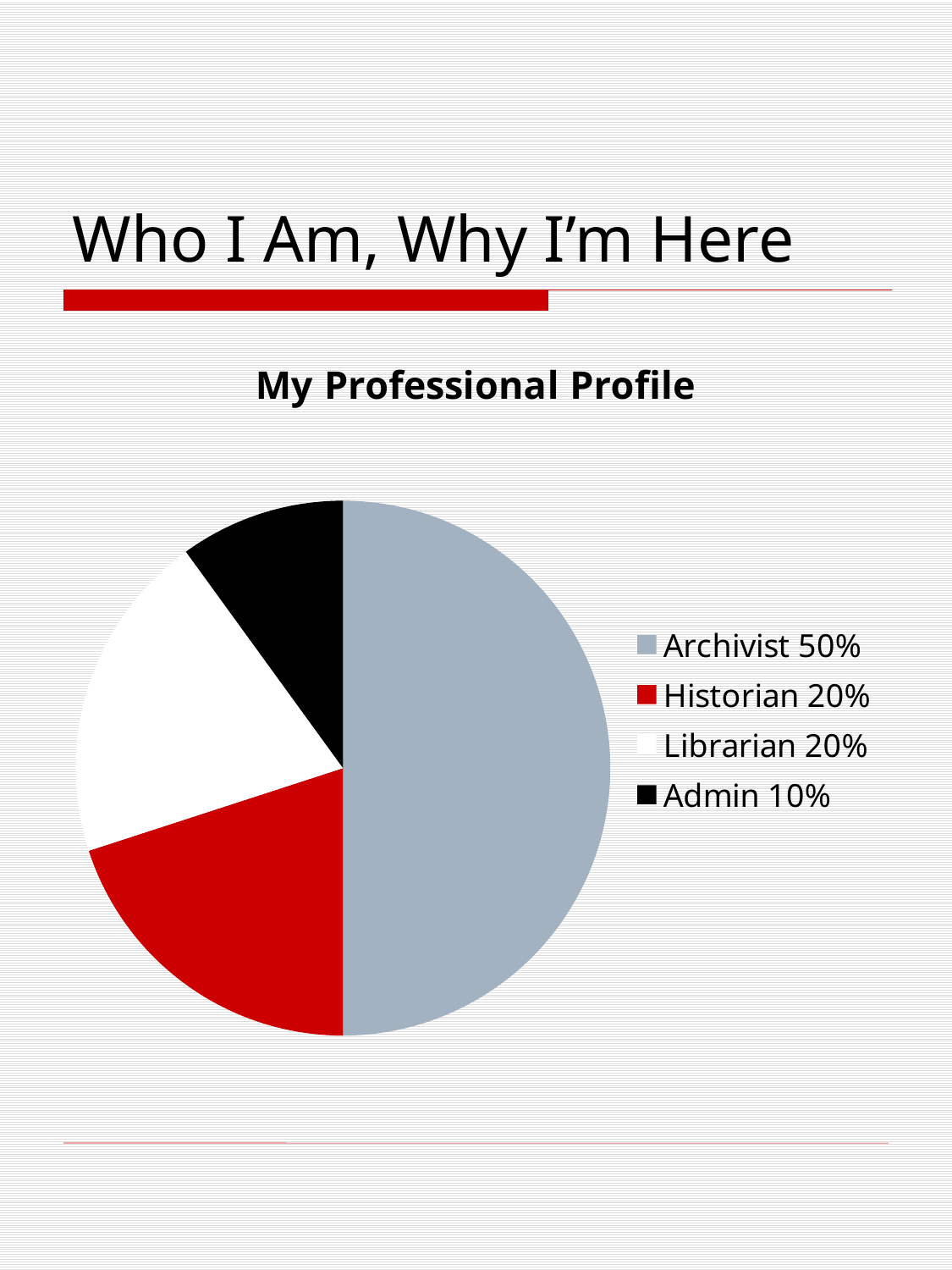
What is the combined share of Historian and Librarian? 40% What is the title of the chart? My Professional Profile What share of the pie does Archivist represent? 50% Which is larger, the Historian slice or the Admin slice? Historian Which category has the largest slice? Archivist How many slices does the pie chart have? 4 What is the difference in percentage points between the Archivist and Librarian slices? 30% What colour is the Historian slice? red Which category has the smallest slice? Admin What share of the pie does Admin represent? 10% What type of chart is shown on the slide? pie chart What share of the pie does Historian represent? 20%